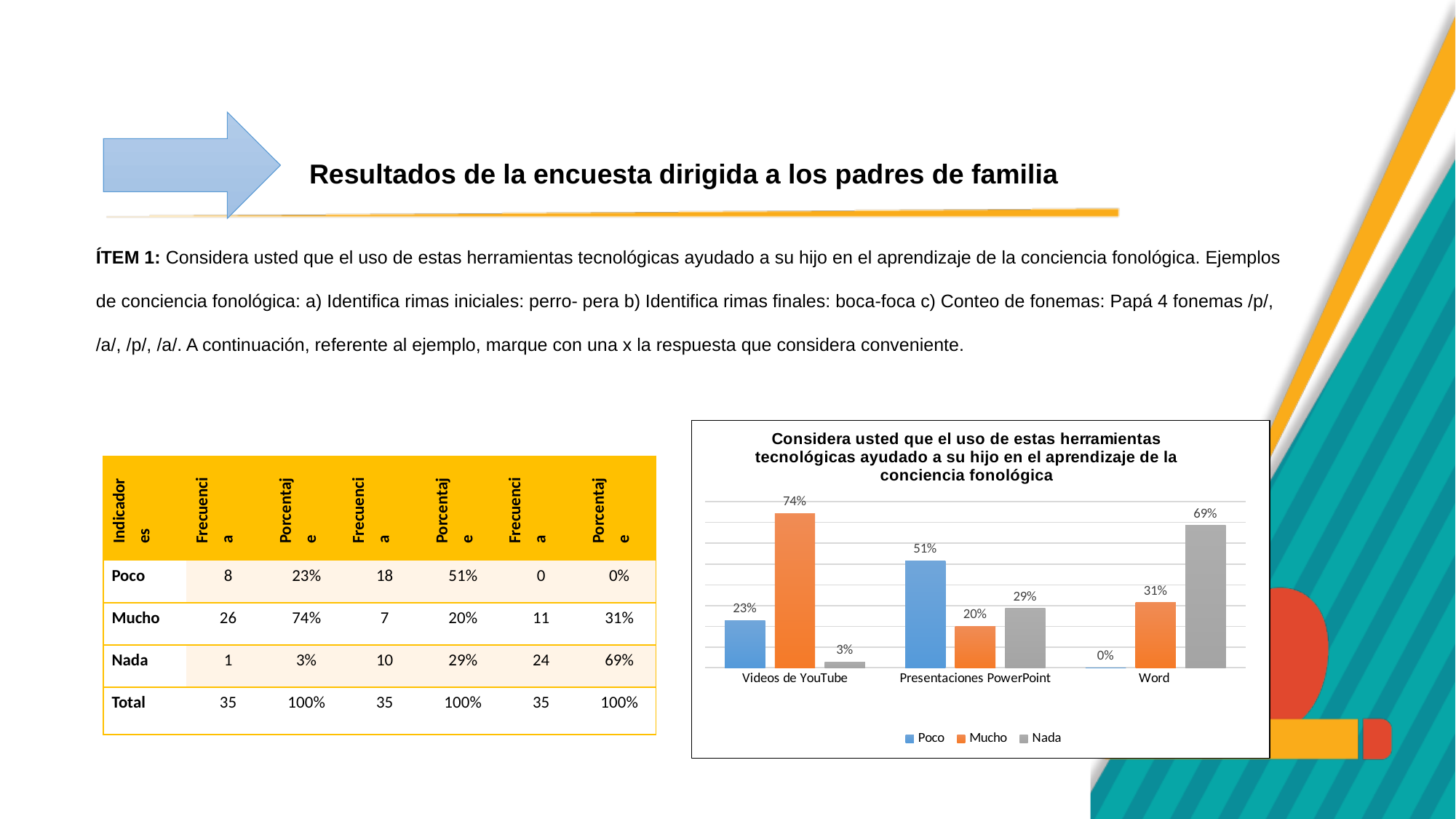
Which category has the lowest value for the Mucho series? Presentaciones PowerPoint What is the value for Poco in the Presentaciones PowerPoint category? 51% What kind of chart is shown? Bar chart Which is larger in the Presentaciones PowerPoint category: Mucho or Nada? Nada How many categories are shown on the x axis? 3 What is the value for Nada in the Word category? 69% What is the value for Poco in the Word category? 0% Which category has the highest value for the Nada series? Word What is the value for Mucho in the Videos de YouTube category? 74% How many series does the legend list? 3 Which series is shown in orange? Mucho What is the difference between the Mucho and Poco values in the Videos de YouTube category? 51%